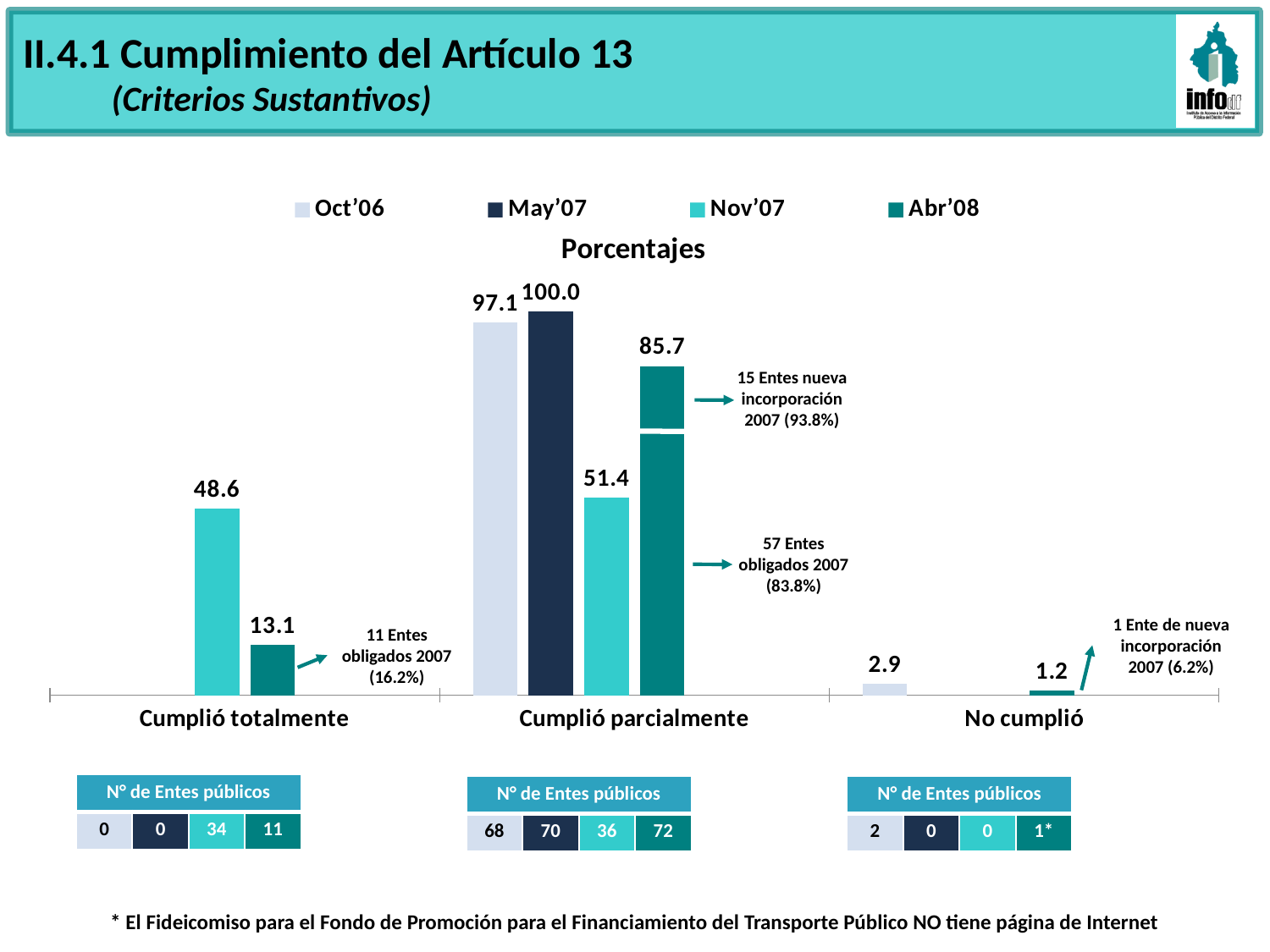
How many categories are shown on the x axis? 3 What kind of chart is shown on the slide? bar chart What is the value for Abr'08 in the 'Cumplió totalmente' category? 13.1 What is the value for May'07 in the 'Cumplió parcialmente' category? 100.0 What is the title of the chart? Porcentajes Which is larger in the 'No cumplió' category: the Oct'06 value or the Abr'08 value? Oct'06 What is the value for Oct'06 in the 'No cumplió' category? 2.9 What is the value for Nov'07 in the 'Cumplió totalmente' category? 48.6 Which series has the lowest value in the 'Cumplió parcialmente' category? Nov'07 What is the difference between the Oct'06 and Nov'07 values in the 'Cumplió parcialmente' category? 45.7 How many series does the legend list? 4 Which series has the highest value in the 'Cumplió parcialmente' category? May'07